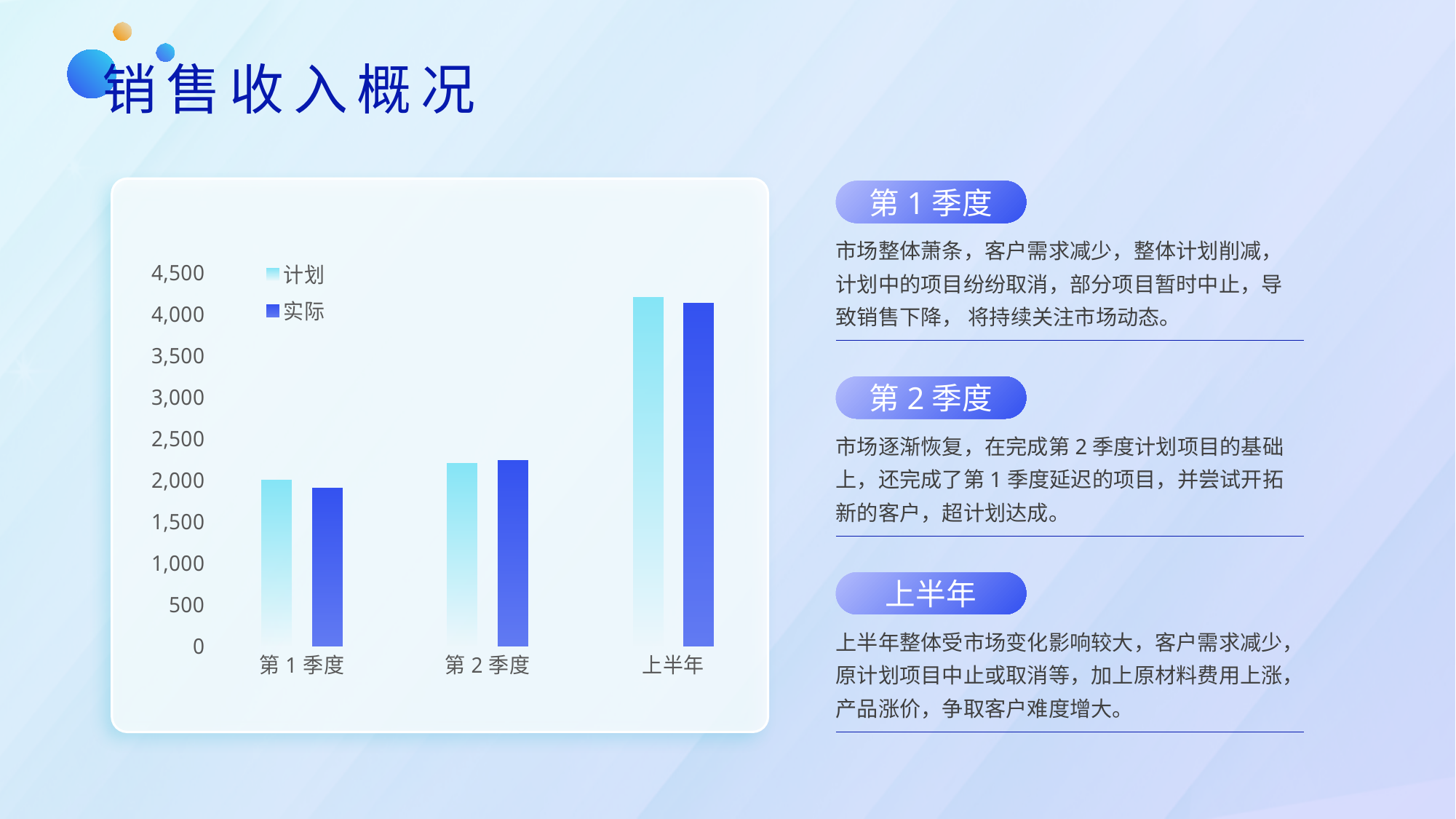
Do the 计划 values rise or fall from 第 1 季度 to 上半年 along the x axis? rise Which category has the highest 计划 value? 上半年 Is the 实际 value for 第 1 季度 greater or less than 2,500? less Is the 计划 value for 第 1 季度 greater or less than 1,500? greater What are the two series named in the chart legend? 计划 and 实际 How many series does the chart legend list? 2 Is the 计划 value for 上半年 greater or less than 4,000? greater Which is larger, the 计划 value for 上半年 or the 计划 value for 第 2 季度? 上半年 What kind of chart is shown on the slide? bar chart Which category has the lowest 实际 value? 第 1 季度 How many categories are shown on the x axis of the chart? 3